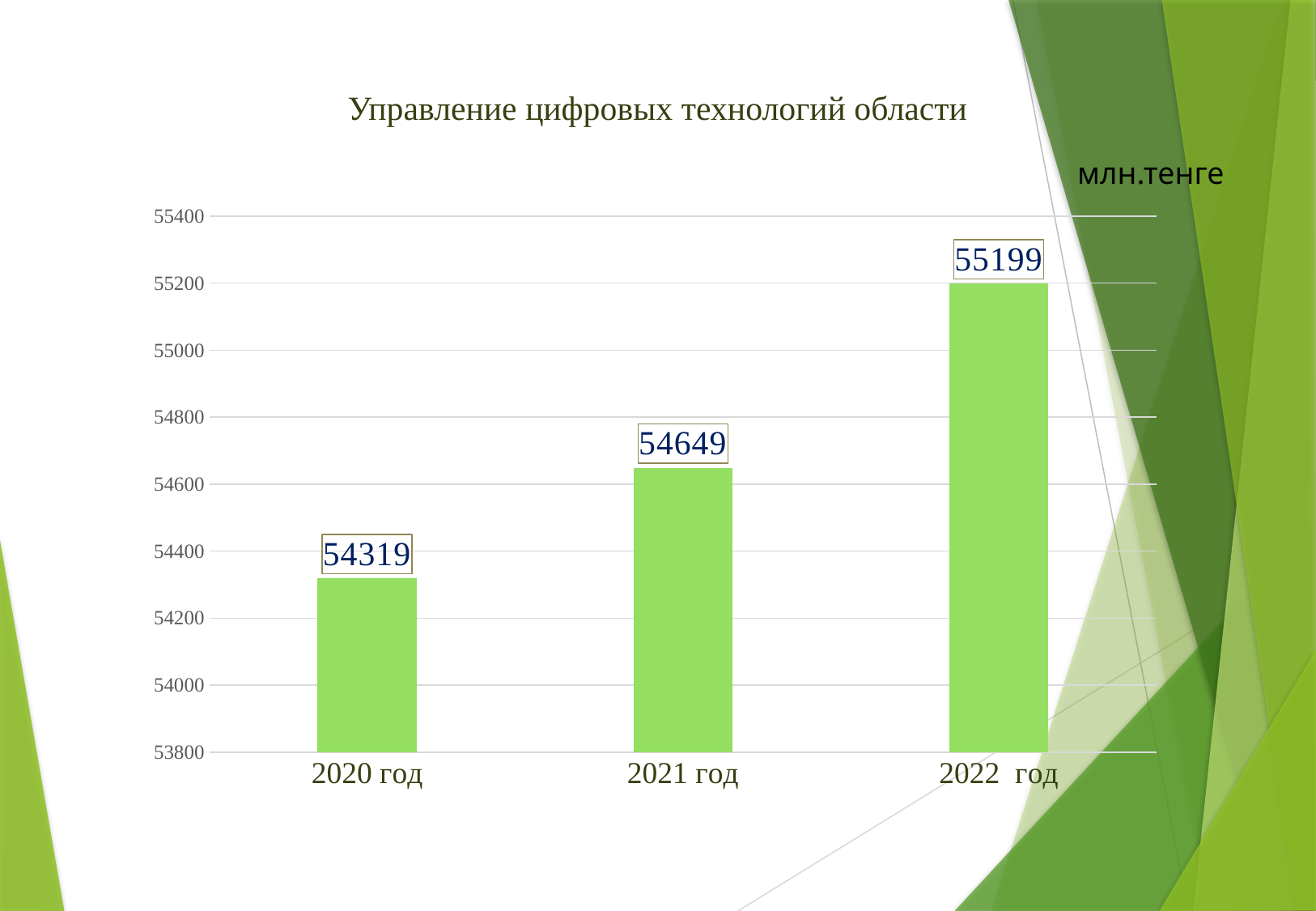
What kind of chart is shown on the slide? bar chart Which year has the highest value? 2022 год What is the difference between the values for 2021 год and 2020 год? 330 Do the values rise or fall from 2020 год to 2022 год? rise How many categories are shown on the x axis? 3 What is the value for 2022 год? 55199 What is the value for 2021 год? 54649 Which year has the lowest value? 2020 год Is the value for 2022 год greater or less than 55000? greater What is the difference between the values for 2022 год and 2021 год? 550 What is the value for 2020 год? 54319 Which is larger, the value for 2020 год or the value for 2021 год? 2021 год